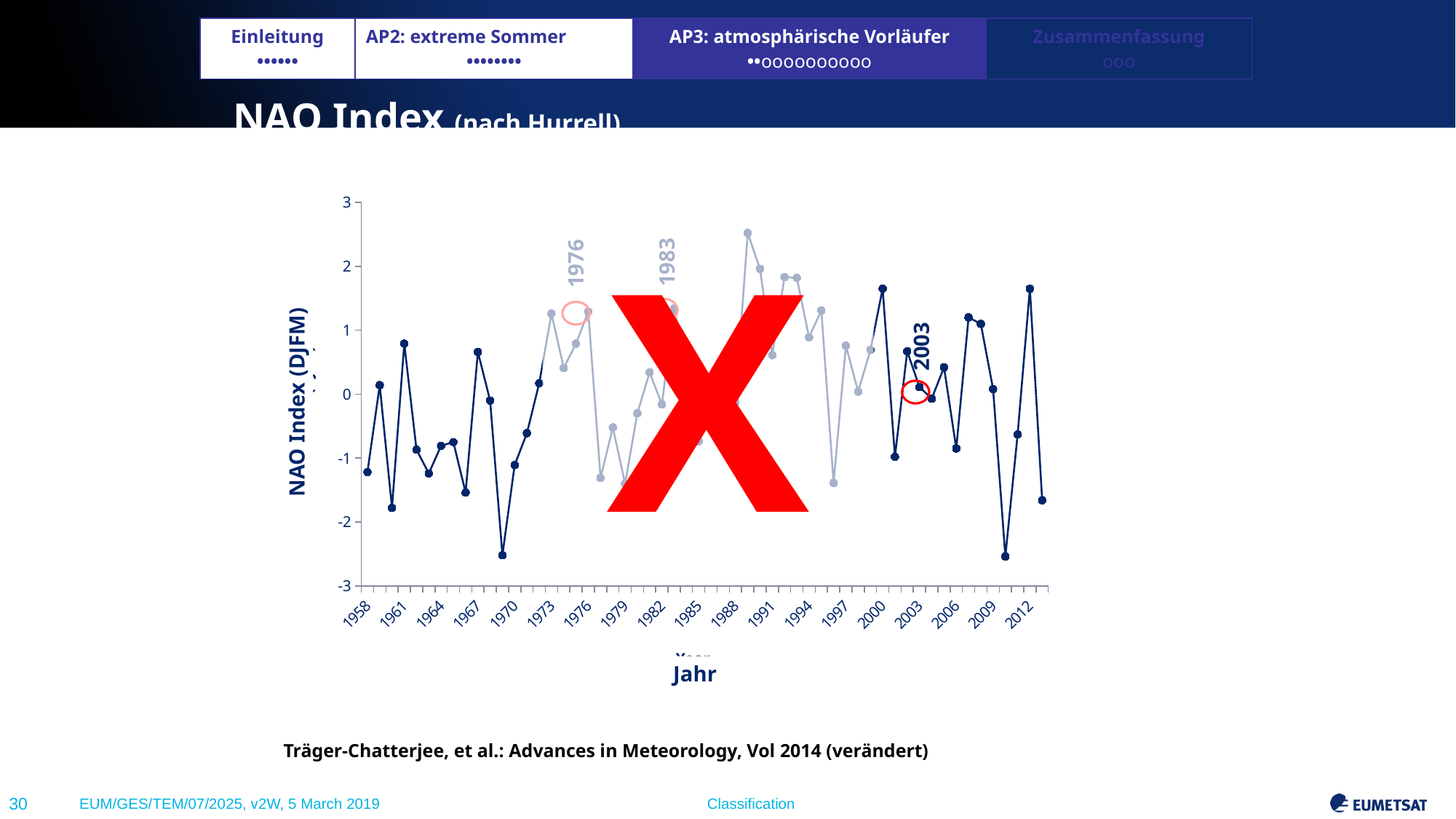
Is the NAO Index value for 2000 greater or less than 1? greater Which year has the highest NAO Index value on the chart? 1989 Is the NAO Index value for 1969 greater or less than -2? less Which year has the lowest NAO Index value in the dark-blue (non-greyed) part of the series before 1976? 1969 What kind of chart is shown on the slide? line chart Is the NAO Index value for 1989 greater or less than 2? greater Between 1967 and 1969, do the NAO Index values rise or fall? fall What is the label of the y axis of the chart? NAO Index (DJFM) Which year has the larger NAO Index value, 1989 or 2000? 1989 Which three years are annotated with circles on the chart? 1976, 1983, 2003